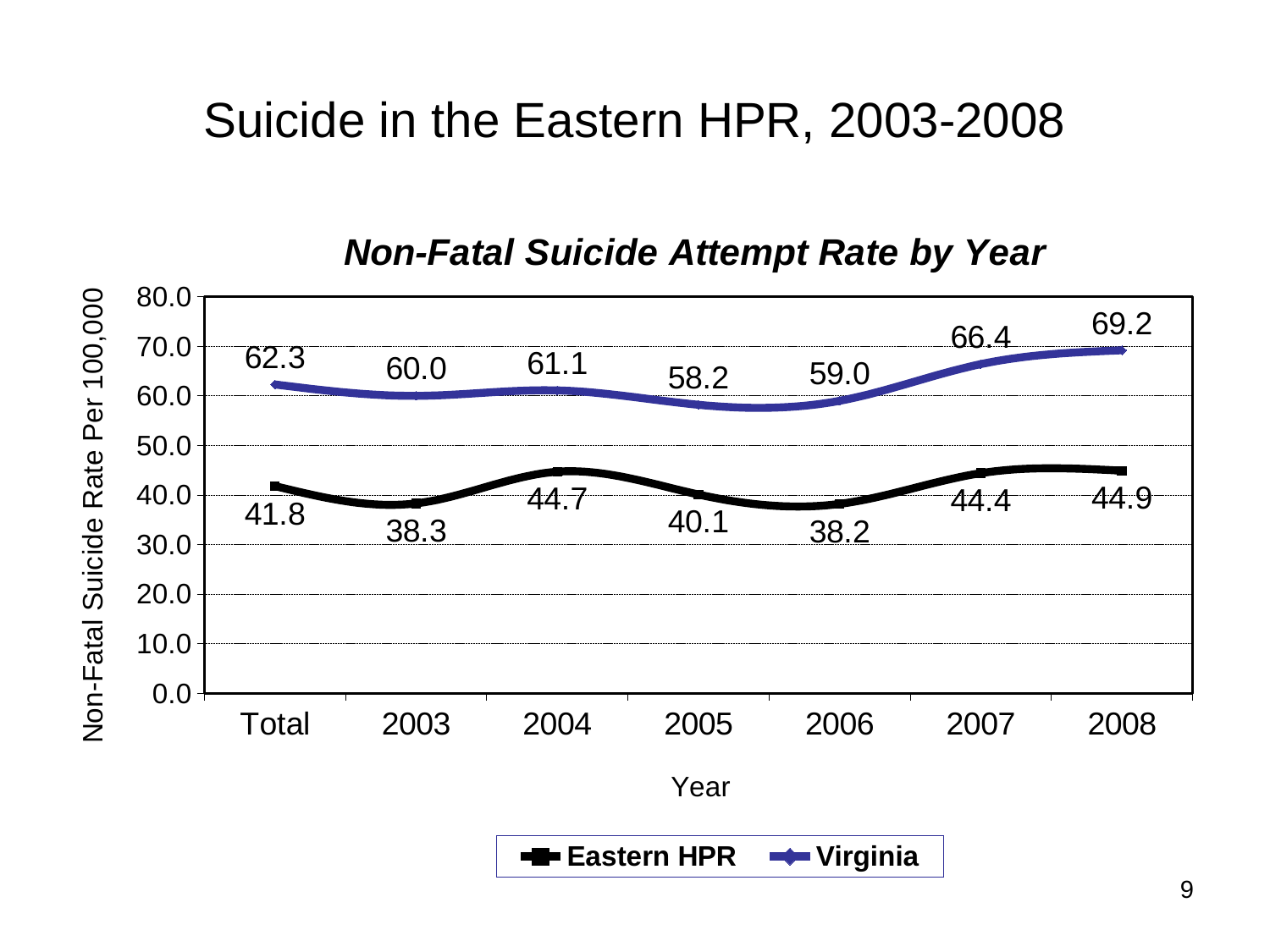
What is the non-fatal suicide attempt rate for Virginia in 2008? 69.2 What kind of chart is shown on the slide? Line chart Which series has the higher rate in 2005, Eastern HPR or Virginia? Virginia What is the difference between the Virginia and Eastern HPR rates in 2007? 22.0 How many categories are shown on the x axis? 7 What is the title of the chart? Non-Fatal Suicide Attempt Rate by Year How many series does the legend list? 2 In which year is the Virginia rate highest? 2008 Does the Virginia rate rise or fall from 2006 to 2008? Rise What is the non-fatal suicide attempt rate for Eastern HPR in 2006? 38.2 In which year is the Eastern HPR rate lowest? 2006 What is the Eastern HPR value for the Total category? 41.8